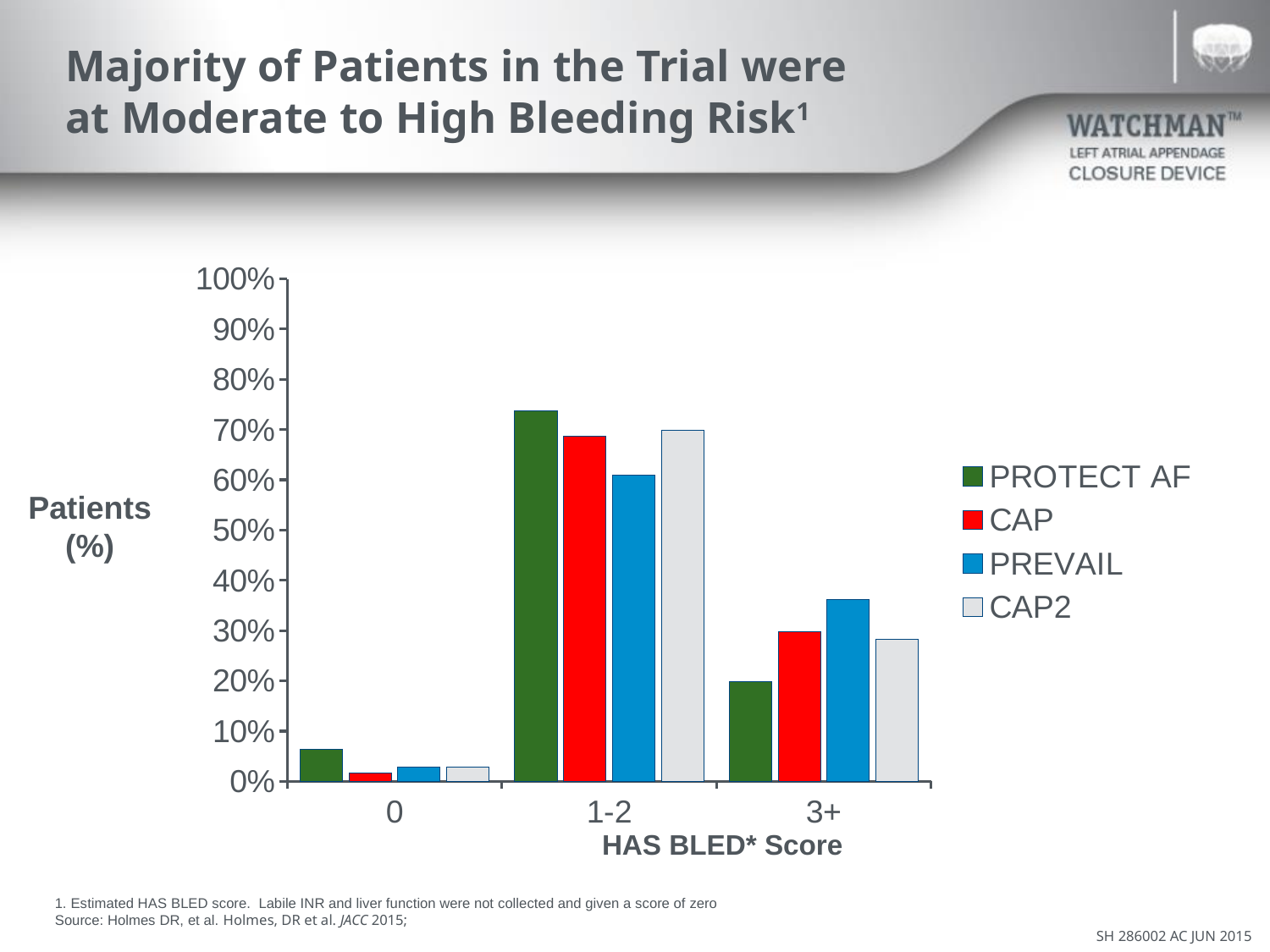
Is the value for PROTECT AF at HAS BLED score 1-2 greater or less than 70%? greater How many series does the legend list? 4 Which HAS BLED score category has the highest value for PROTECT AF? 1-2 Is the value for PREVAIL at HAS BLED score 1-2 greater or less than 70%? less At HAS BLED score 3+, which is larger: PREVAIL or PROTECT AF? PREVAIL What is the title of the x axis? HAS BLED* Score What kind of chart is shown on the slide? Bar chart At HAS BLED score 1-2, which is larger: PROTECT AF or PREVAIL? PROTECT AF How many HAS BLED score categories are shown on the x axis? 3 Is the value for PREVAIL at HAS BLED score 3+ greater or less than 30%? greater Which HAS BLED score category has the lowest value for PREVAIL? 0